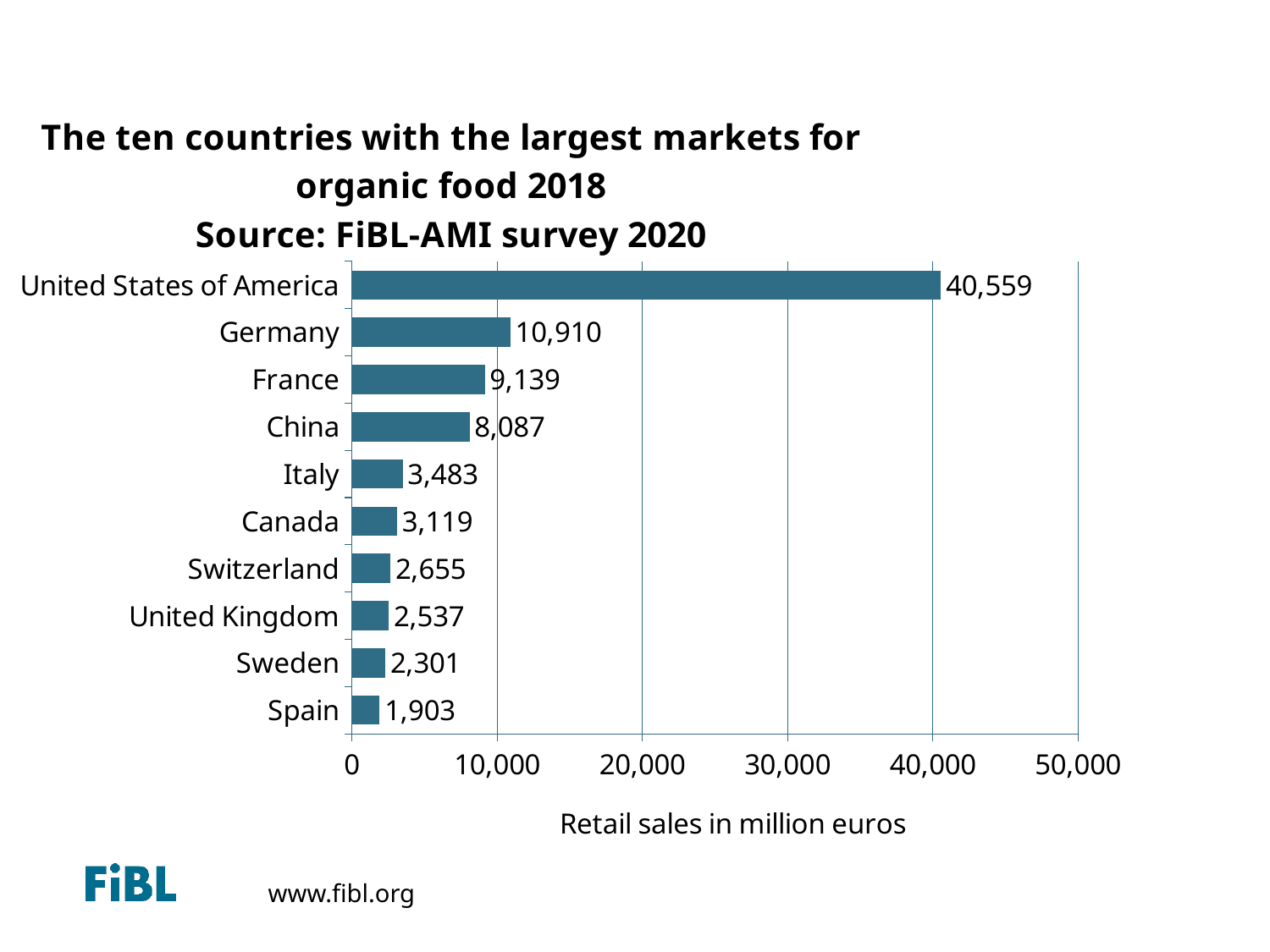
What is the label of the horizontal axis? Retail sales in million euros Which country has the largest market for organic food? United States of America Which country has the smallest value shown on the chart? Spain What is the difference between the values for the United States of America and Germany? 29,649 How many countries are shown on the chart? 10 What is the retail sales value for Sweden? 2,301 What is the retail sales value for China? 8,087 What kind of chart is shown on the slide? Bar chart What is the retail sales value for Germany? 10,910 What is the difference between the values for France and China? 1,052 Which has a larger value, Italy or Canada? Italy Is the value for the United States of America greater or less than 40,000? greater